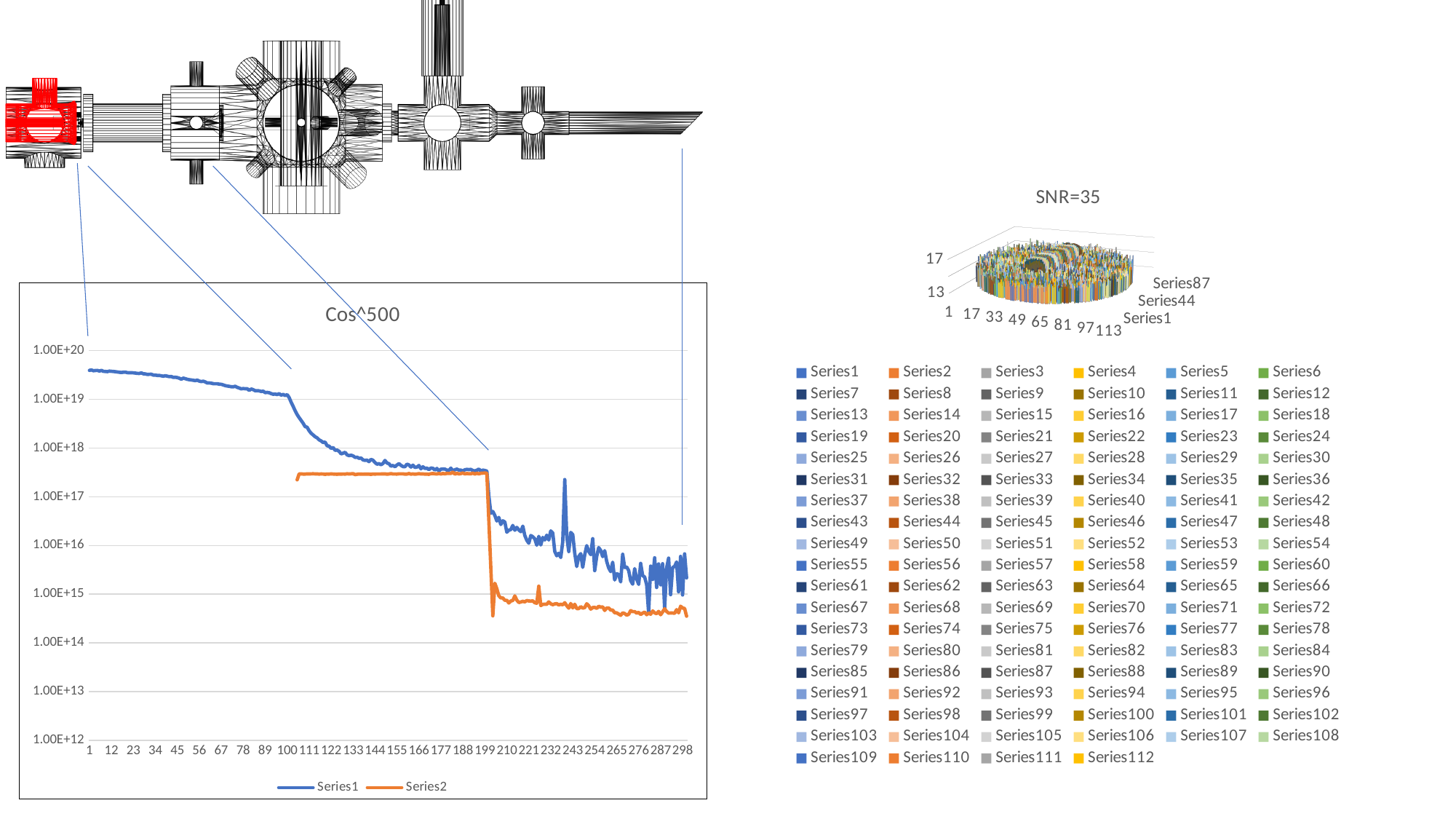
What is the highest value shown on the y axis of the Cos^500 chart? 1.00E+20 In the Cos^500 chart, is the value of Series1 at x = 150 greater or less than 1.00E+18? less In the Cos^500 chart, is the value of Series2 at x = 150 greater or less than 1.00E+17? greater In the Cos^500 chart, which series has the larger value at x = 250, Series1 or Series2? Series1 In the Cos^500 chart, does Series1 generally rise or fall as x increases? fall What kind of chart is the chart titled SNR=35? 3D bar chart How many series does the legend of the SNR=35 chart list? 112 How many series does the legend of the Cos^500 chart list? 2 What is the title of the chart on the right side of the slide? SNR=35 What kind of chart is the chart titled Cos^500? line chart In the Cos^500 chart, is the value of Series1 at x = 1 greater or less than 1.00E+19? greater